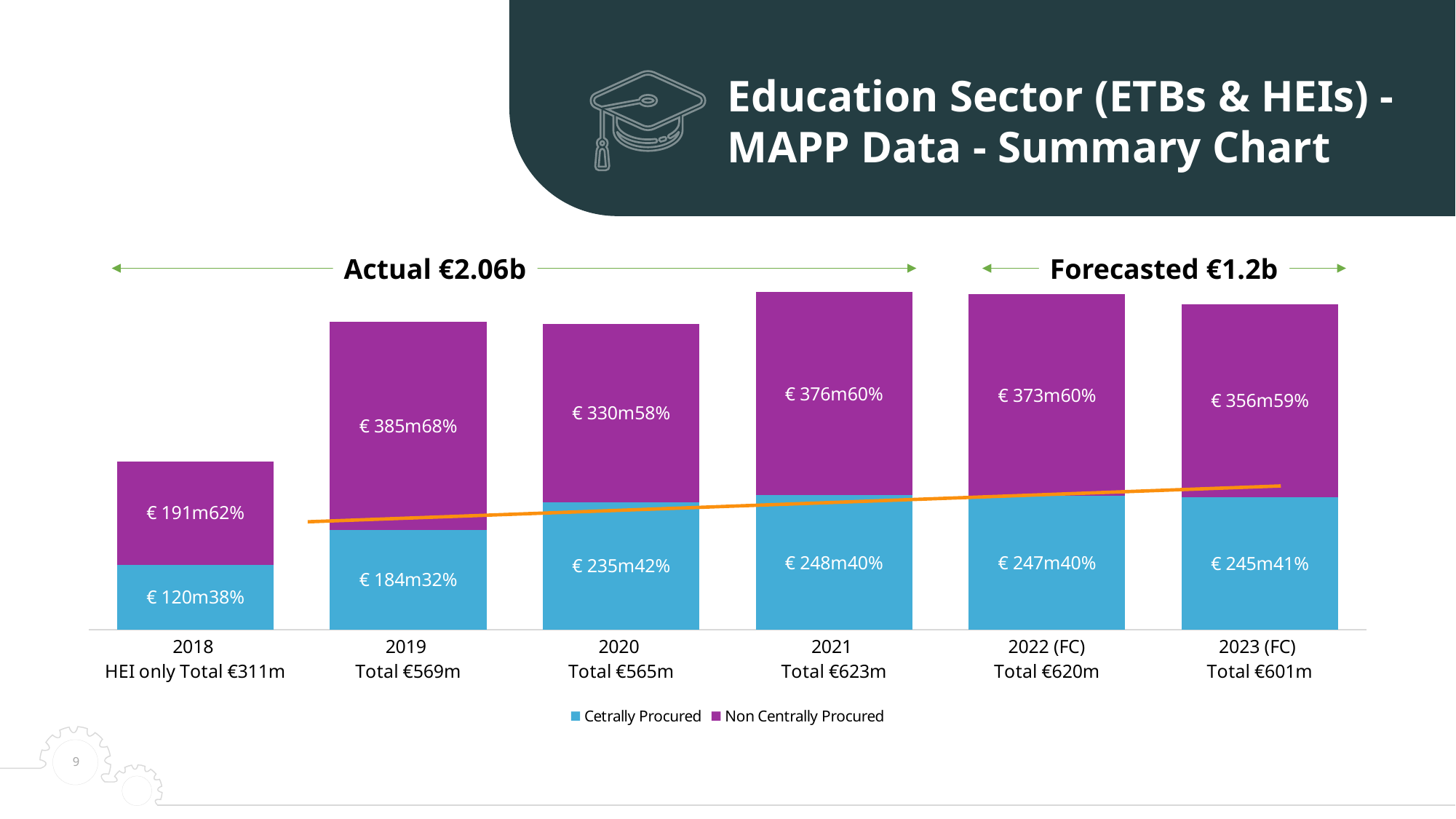
What is the difference between the Non Centrally Procured values for 2019 and 2020? € 55m Which series is shown in purple? Non Centrally Procured Which is larger, the Centrally Procured value for 2020 or for 2021? 2021 Which year has the highest total? 2021 What is the total shown for 2023 (FC)? €601m How many series does the legend list? 2 What is the Non Centrally Procured value for 2021? € 376m What percentage of the 2019 total was Non Centrally Procured? 68% Which year has the lowest total? 2018 What kind of chart is shown on the slide? Stacked bar chart What is the Centrally Procured value for 2018? € 120m How many years are shown on the x axis? 6